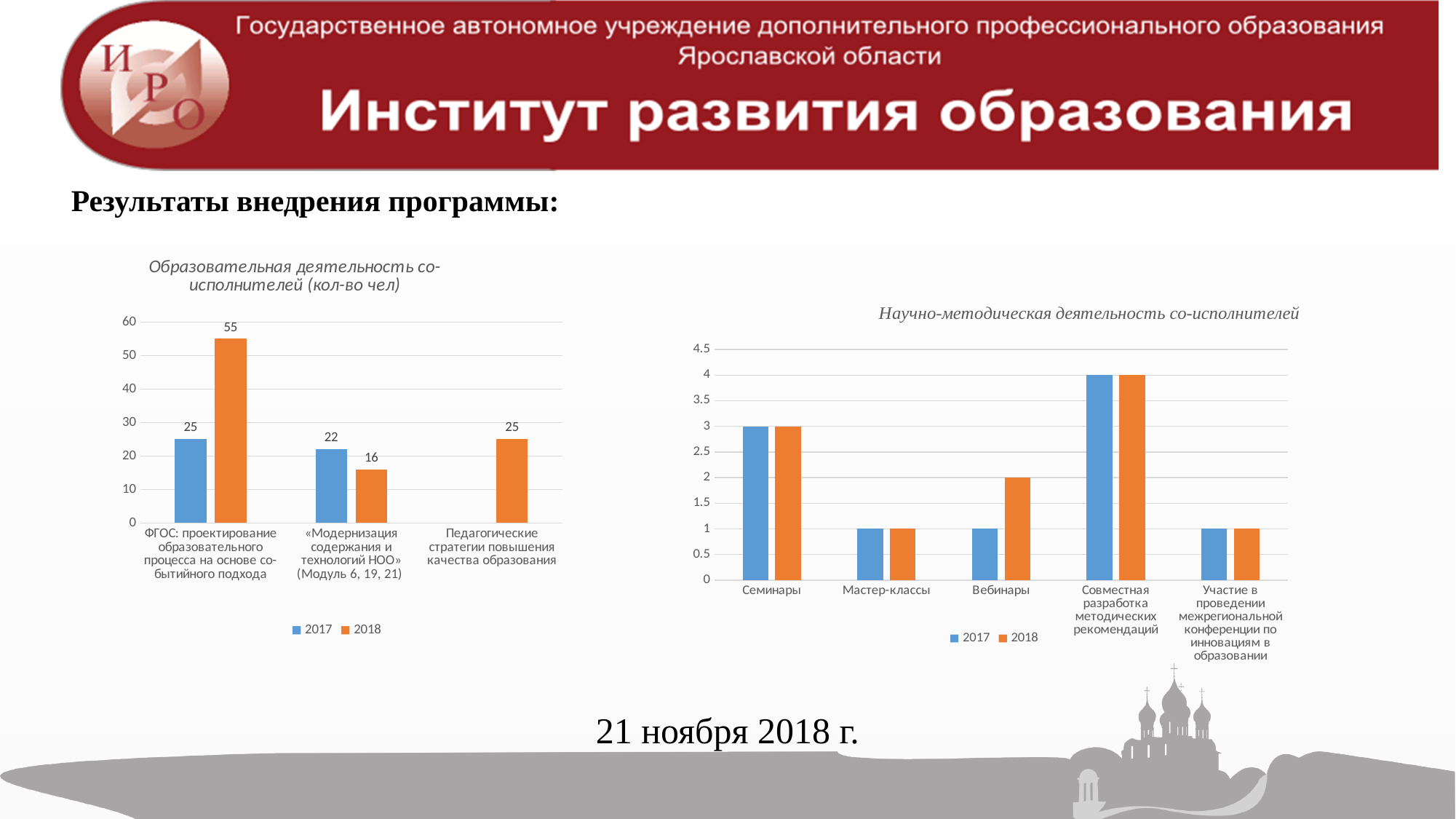
In the left chart (Образовательная деятельность со-исполнителей), what is the difference between the 2018 and 2017 values for «ФГОС: проектирование образовательного процесса на основе со-бытийного подхода»? 30 In the left chart (Образовательная деятельность со-исполнителей), what is the 2017 value for «Модернизация содержания и технологий НОО» (Модуль 6, 19, 21)? 22 In the right chart (Научно-методическая деятельность со-исполнителей), how many categories are shown on the x axis? 5 In the left chart (Образовательная деятельность со-исполнителей), what is the 2018 value for «ФГОС: проектирование образовательного процесса на основе со-бытийного подхода»? 55 In the right chart (Научно-методическая деятельность со-исполнителей), which category has the highest values? Совместная разработка методических рекомендаций In the left chart (Образовательная деятельность со-исполнителей), for «Модернизация содержания и технологий НОО», which year has the larger value, 2017 or 2018? 2017 What type of chart is the right chart (Научно-методическая деятельность со-исполнителей)? Bar chart In the right chart (Научно-методическая деятельность со-исполнителей), what is the 2018 value for Вебинары? 2 In the right chart (Научно-методическая деятельность со-исполнителей), how many series does the legend list? 2 In the left chart (Образовательная деятельность со-исполнителей), what is the 2018 value for «Педагогические стратегии повышения качества образования»? 25 In the left chart (Образовательная деятельность со-исполнителей), how many categories are shown on the x axis? 3 In the left chart (Образовательная деятельность со-исполнителей), which category has the highest 2018 value? ФГОС: проектирование образовательного процесса на основе со-бытийного подхода